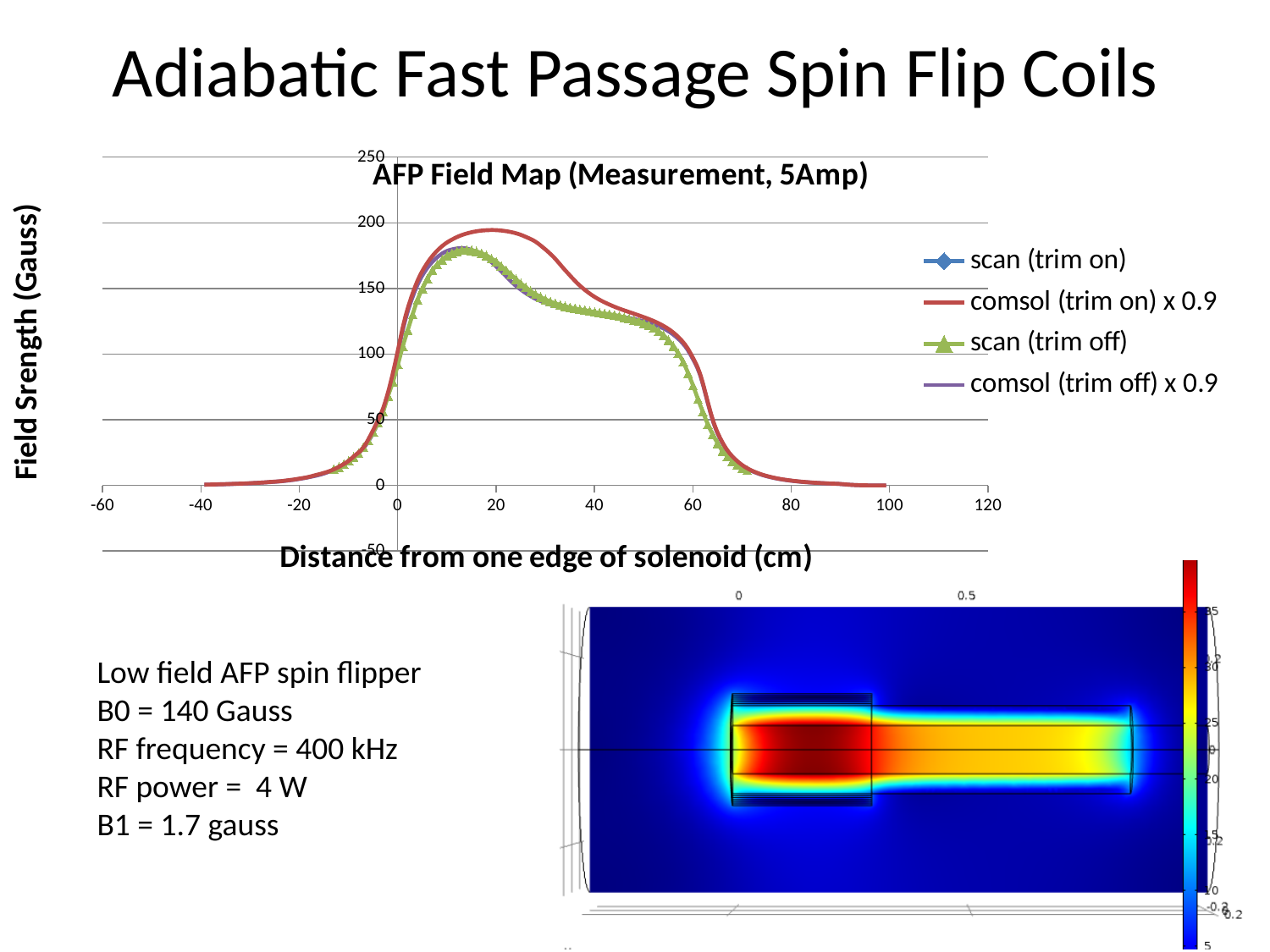
In the AFP Field Map chart, which series reaches the highest peak field strength? comsol (trim on) x 0.9 In the AFP Field Map chart, is the peak value of the comsol (trim on) x 0.9 series greater or less than 150? greater In the AFP Field Map chart, do the field strength values rise or fall as the distance increases from -20 cm to 10 cm? rise What kind of chart is the AFP Field Map (Measurement, 5Amp)? line chart In the AFP Field Map chart, do the field strength values rise or fall as the distance increases from 20 cm to 70 cm? fall In the AFP Field Map chart, at a distance of 30 cm, which series has the larger value: comsol (trim on) x 0.9 or scan (trim off)? comsol (trim on) x 0.9 In the AFP Field Map chart, is the value of the scan (trim off) series at a distance of 40 cm greater or less than 100? greater In the AFP Field Map chart, is the peak value of the scan (trim off) series greater or less than 200? less How many series does the legend of the AFP Field Map chart list? 4 What is the x-axis label of the AFP Field Map chart? Distance from one edge of solenoid (cm) What is the title of the chart on the slide? AFP Field Map (Measurement, 5Amp)